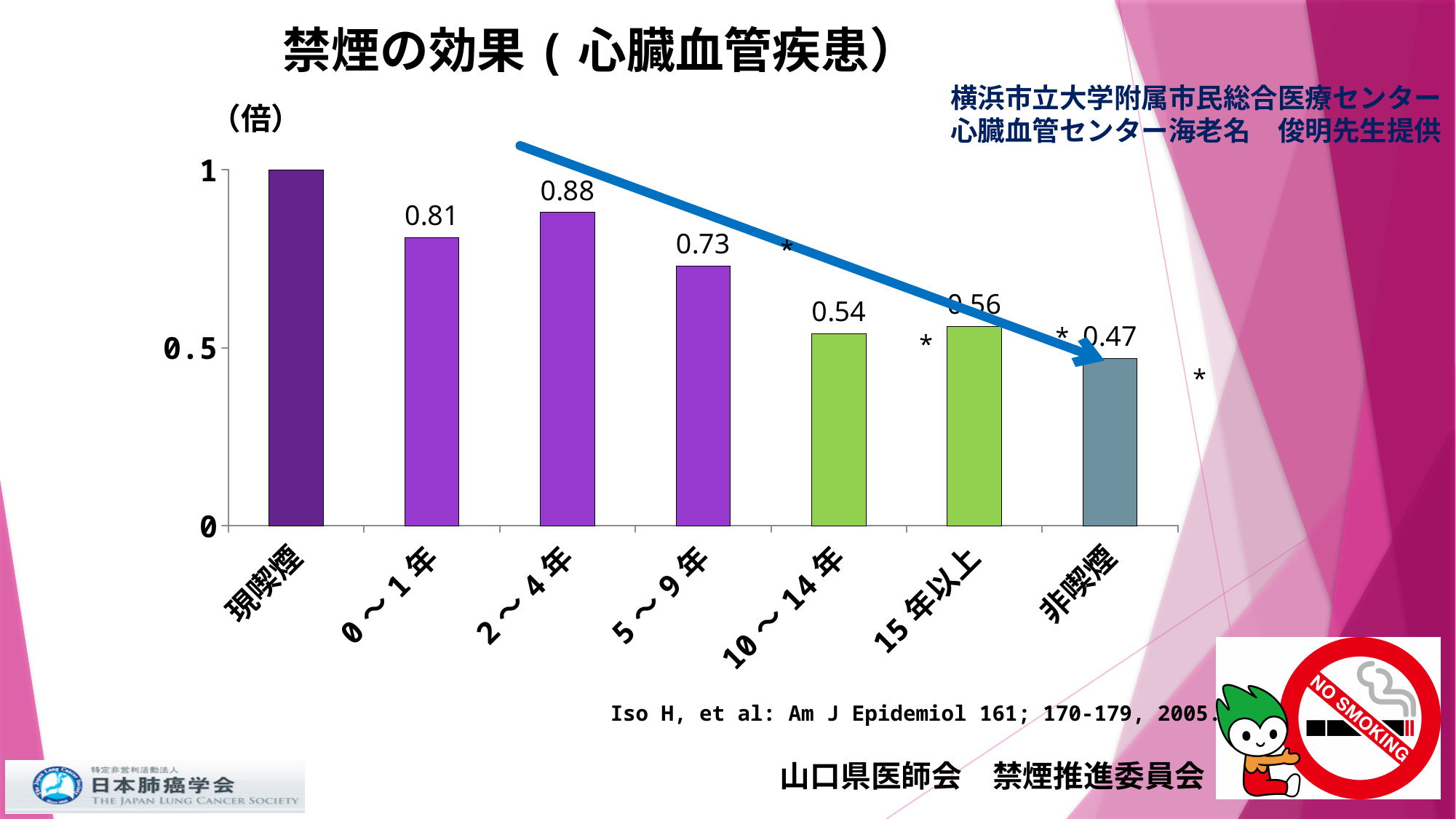
What is the title of the chart? 禁煙の効果（心臓血管疾患） What is the value for 2～4年? 0.88 What is the value for 0～1年? 0.81 What kind of chart is shown on the slide? bar chart What is the difference between the values for 2～4年 and 0～1年? 0.07 Is the value for 現喫煙 greater or less than 0.5? greater How many categories are shown on the x axis? 7 Which category has the lowest value? 非喫煙 What is the value for 非喫煙? 0.47 What is the value for 5～9年? 0.73 Which category has the highest value? 現喫煙 Which is larger, the value for 10～14年 or the value for 15年以上? 15年以上